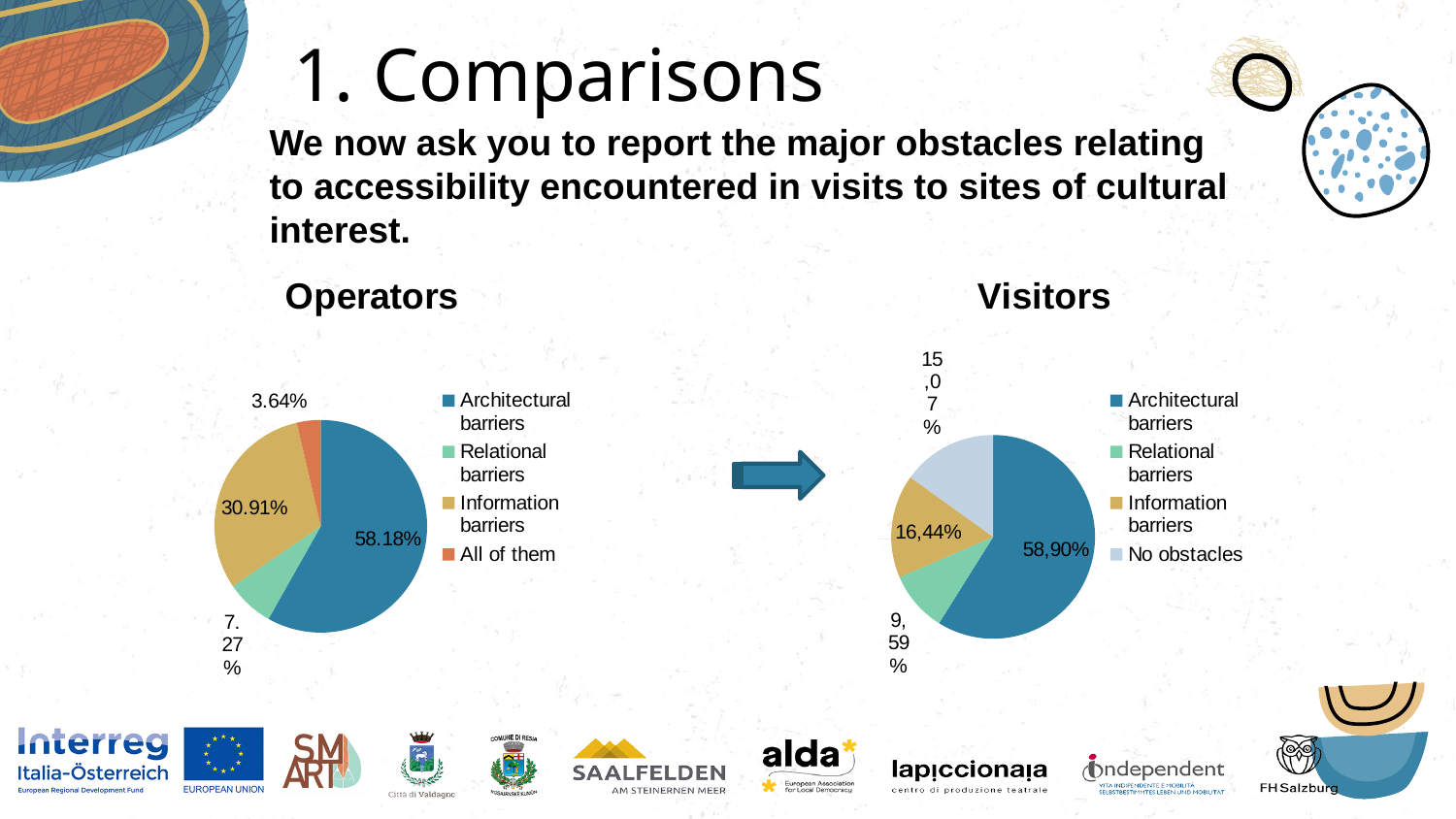
In the Visitors chart, which category has the smallest slice? Relational barriers In the Operators chart, what share is labelled for Architectural barriers? 58.18% What type of chart is the Operators chart? Pie chart In the Operators chart, which category has the largest slice? Architectural barriers In the Visitors chart, which is larger: Information barriers or Relational barriers? Information barriers In the Operators chart, which category has the smallest slice? All of them In the Operators chart, what share is labelled for Information barriers? 30.91% In the Visitors chart, what share is labelled for No obstacles? 15,07% In the Operators chart, what share is labelled for All of them? 3.64% In the Visitors chart, what share is labelled for Architectural barriers? 58,90% In the Visitors chart, what share is labelled for Information barriers? 16,44% How many categories does the legend of the Visitors chart list? 4